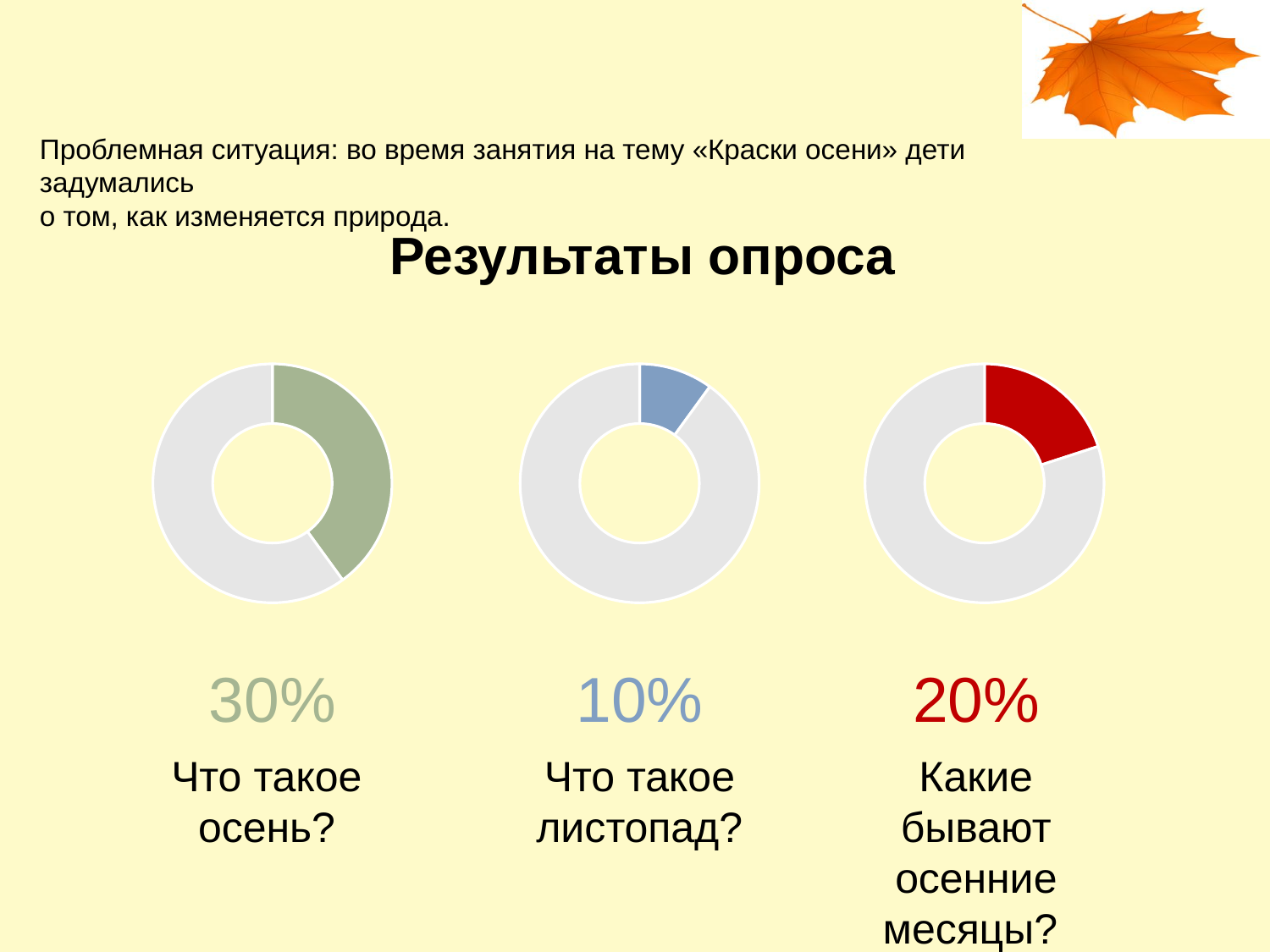
What kind of chart is used on this slide? Donut (pie) chart What percentage is shown for the chart labelled «Какие бывают осенние месяцы?»? 20% Which of the three questions has the lowest percentage? Что такое листопад? What percentage is shown for the chart labelled «Что такое листопад?»? 10% What is the difference between the percentage for «Что такое осень?» and the percentage for «Что такое листопад?»? 20% What percentage is shown for the chart labelled «Что такое осень?»? 30% What is the title above the charts? Результаты опроса What colour is the highlighted segment of the rightmost chart? Red What is the difference between the percentage for «Какие бывают осенние месяцы?» and the percentage for «Что такое листопад?»? 10% How many charts are shown on the slide? 3 Which of the three questions has the highest percentage? Что такое осень? Which is larger: the percentage for «Какие бывают осенние месяцы?» or the percentage for «Что такое осень?»? Что такое осень?